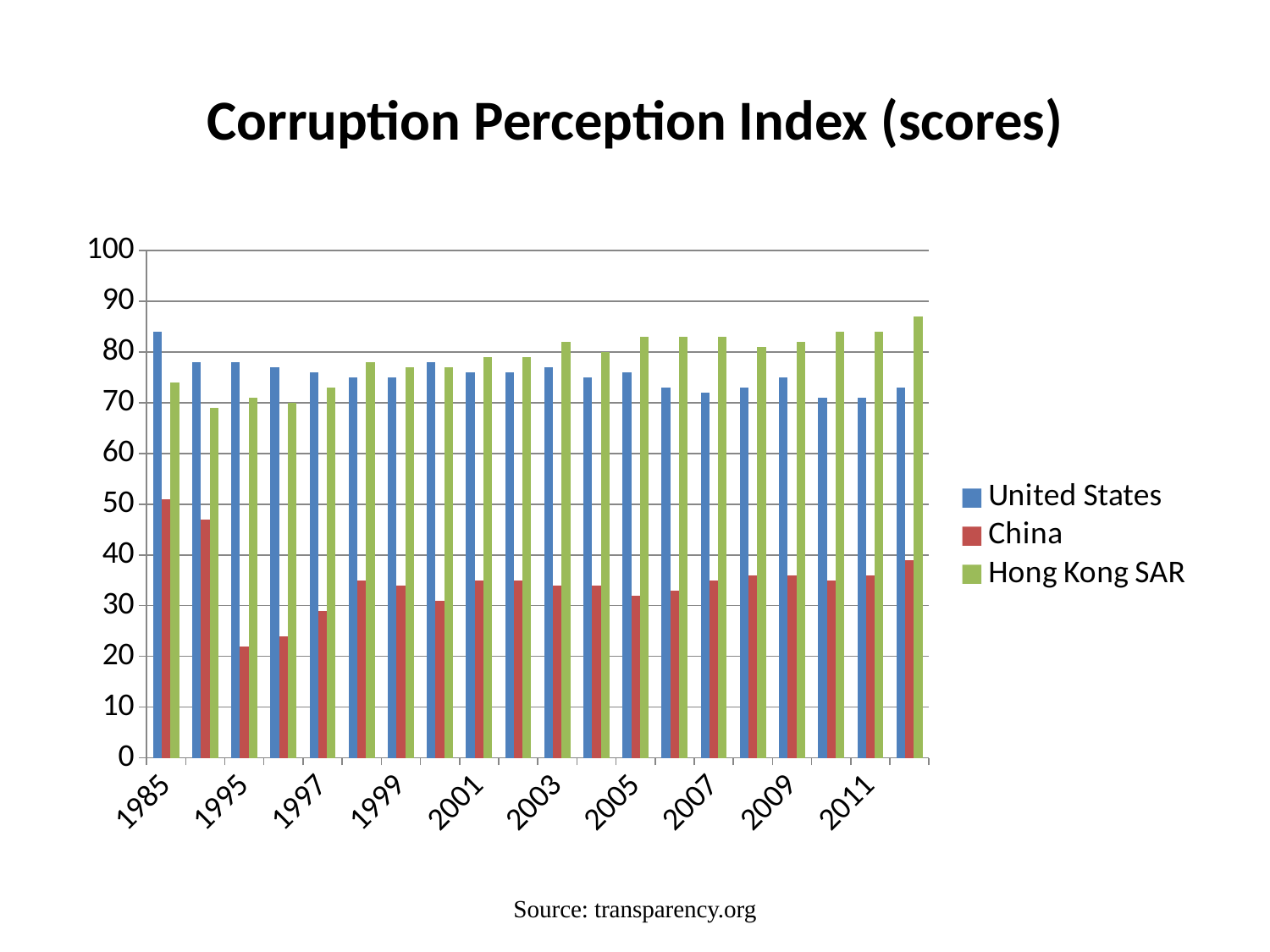
Which series is shown in green in the legend? Hong Kong SAR Is the value for Hong Kong SAR in 2011 greater or less than 80? greater Is the value for United States in 1985 greater or less than 80? greater Which is larger in 2011, the value for United States or the value for Hong Kong SAR? Hong Kong SAR Which is larger in 1985, the value for United States or the value for Hong Kong SAR? United States How many series does the legend list? 3 Which series has the lowest value in 1985? China Is the value for China in 1995 greater or less than 30? less What is the title of the chart? Corruption Perception Index (scores) Do the values for Hong Kong SAR generally rise or fall from 1995 to 2011? rise What kind of chart is shown on the slide? bar chart